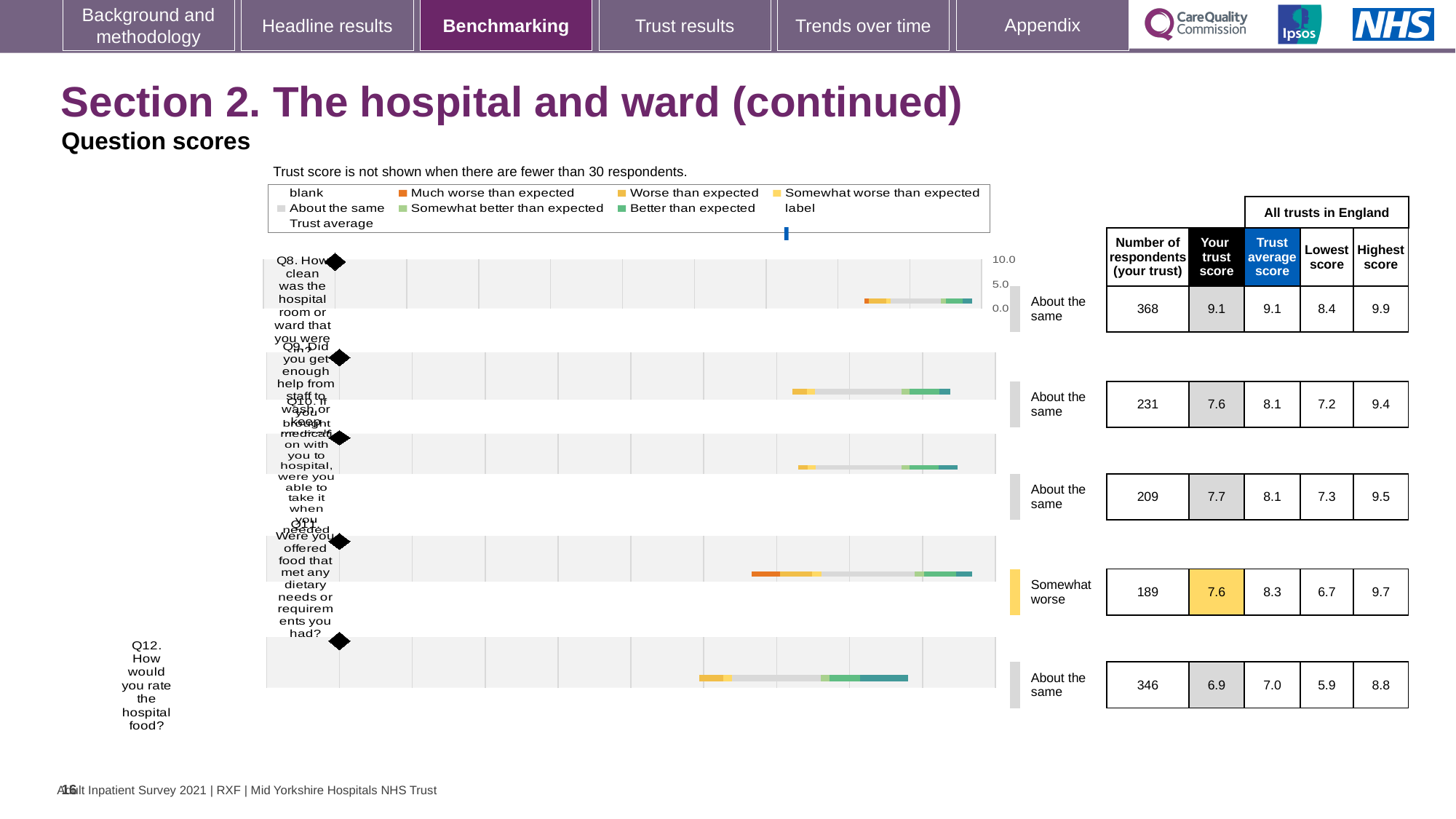
For Q11, what is the difference between the trust average score and your trust score? 0.7 Which question is rated 'Somewhat worse' rather than 'About the same'? Q11 For Q8, what is the difference between the highest score and the lowest score across all trusts in England? 1.5 Which question has the highest 'Your trust score' on this slide? Q8 What is the 'Your trust score' for Q8 (How clean was the hospital room or ward that you were in?)? 9.1 Which question has the lowest 'Your trust score' on this slide? Q12 Which has the higher 'Your trust score': Q9 or Q10? Q10 How many questions are plotted on this slide? 5 How many respondents from your trust answered Q12 (How would you rate the hospital food?)? 346 What kind of chart is used to show the question scores? Bar chart What is the highest score across all trusts in England for Q10? 9.5 What is the lowest score across all trusts in England for Q9? 7.2